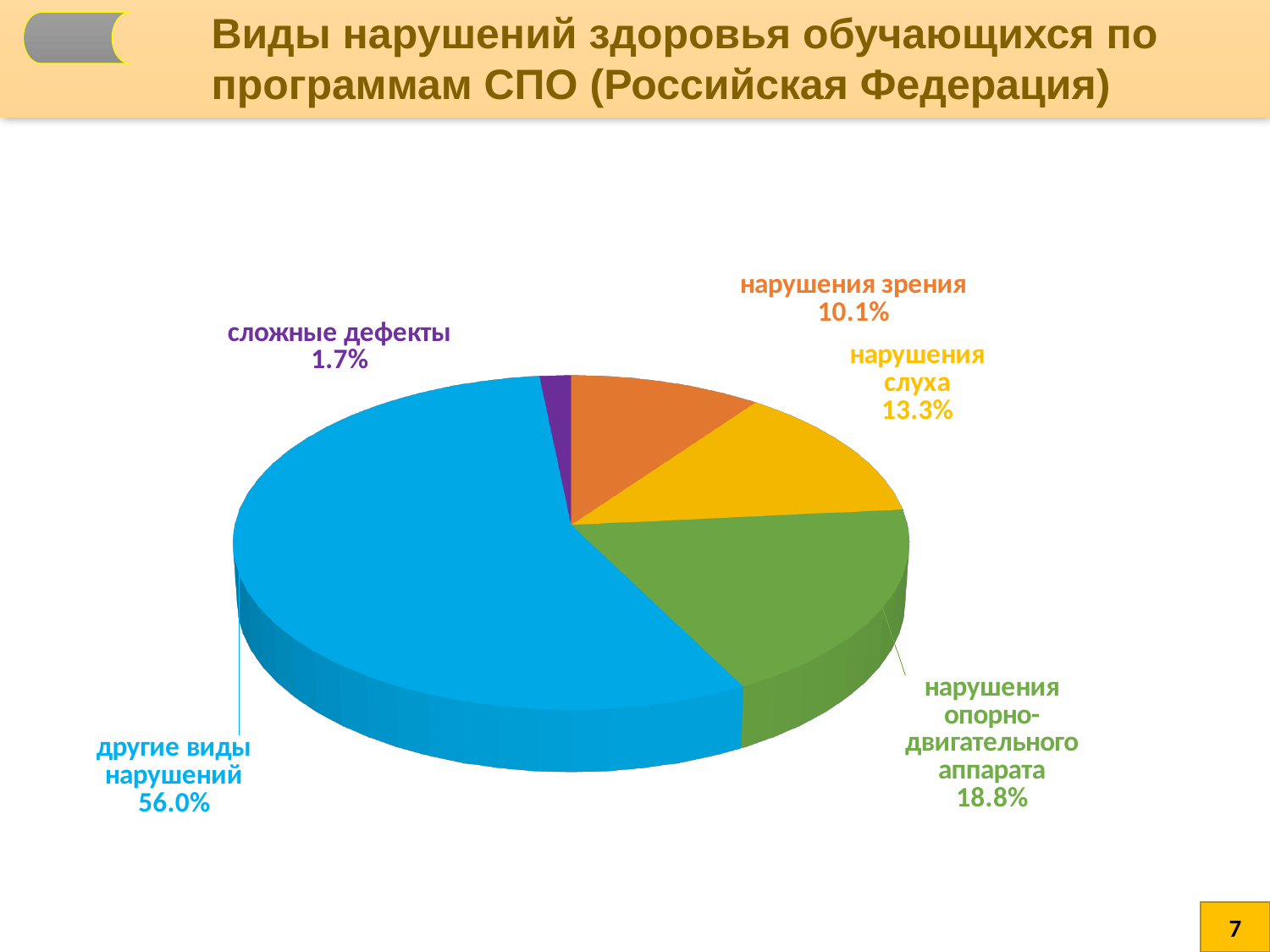
What colour is the slice for 'другие виды нарушений'? blue What is the value shown for 'нарушения опорно-двигательного аппарата'? 18.8% Which category has the largest slice of the pie? другие виды нарушений What is the value shown for 'нарушения зрения'? 10.1% What is the value shown for 'нарушения слуха'? 13.3% What kind of chart is shown on the slide? pie chart What is the value shown for 'сложные дефекты'? 1.7% What is the difference between the shares for 'нарушения опорно-двигательного аппарата' and 'нарушения слуха'? 5.5% Which category has the smallest slice of the pie? сложные дефекты How many slices does the pie chart have? 5 Which is larger: the share for 'нарушения слуха' or the share for 'нарушения зрения'? нарушения слуха What share of the pie is labelled 'другие виды нарушений'? 56.0%